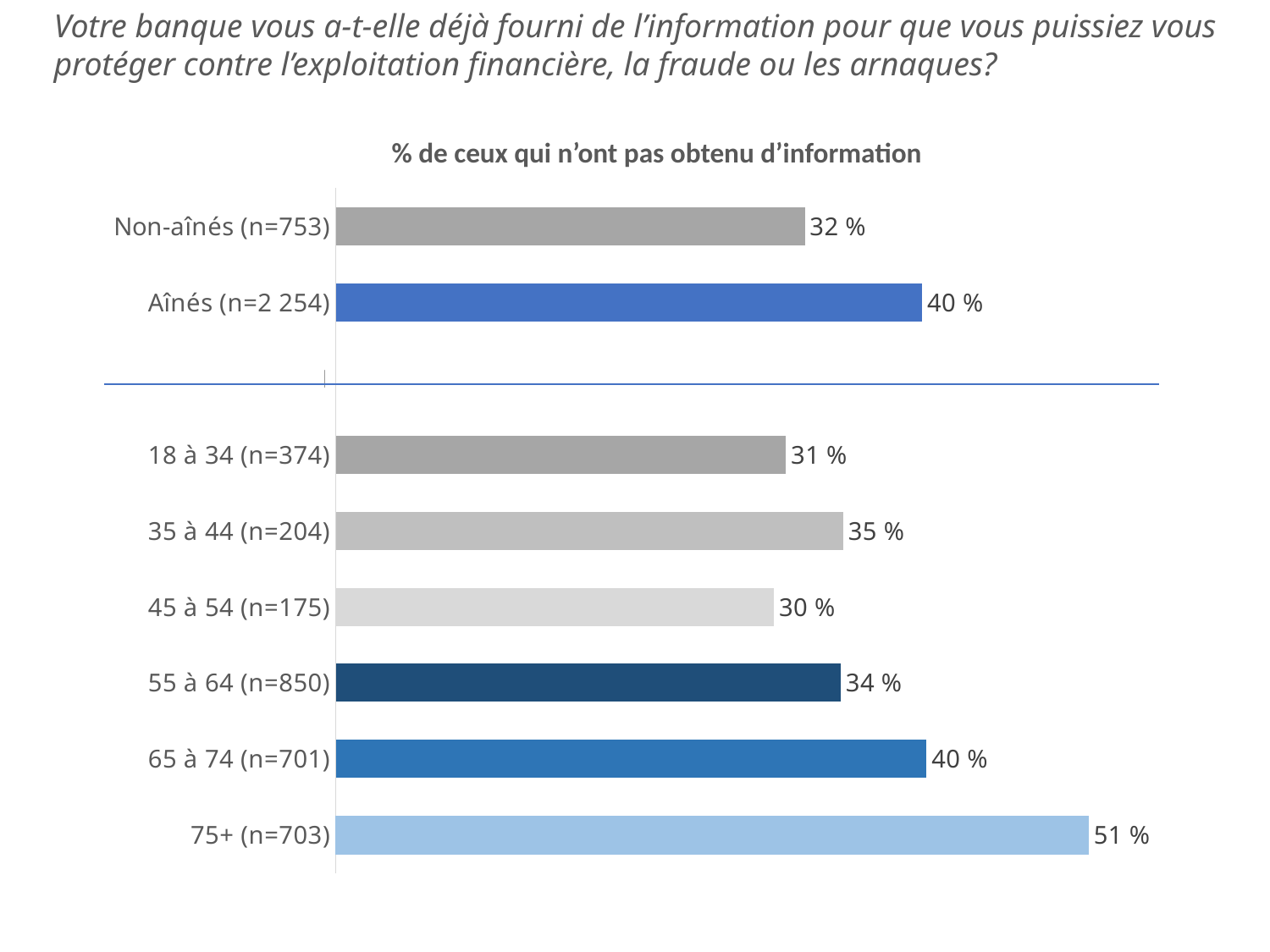
What colour is the bar for the 75+ (n=703) group? Light blue What percentage of Aînés (n=2 254) did not obtain information? 40 % Which category has the highest percentage of those who did not obtain information? 75+ (n=703) What is the difference in percentage points between the 75+ (n=703) group and the 65 à 74 (n=701) group? 11 Which has a higher value: 35 à 44 (n=204) or 55 à 64 (n=850)? 35 à 44 (n=204) What type of chart is shown on the slide? Bar chart Among the age groups from 18 à 34 to 75+, which has the lowest percentage? 45 à 54 (n=175) What is the value shown for the 45 à 54 (n=175) age group? 30 % What is the value shown for the 75+ (n=703) age group? 51 % What is the difference in percentage points between Aînés (n=2 254) and Non-aînés (n=753)? 8 How many bars are plotted on the chart? 8 What is the title of the chart? % de ceux qui n'ont pas obtenu d'information